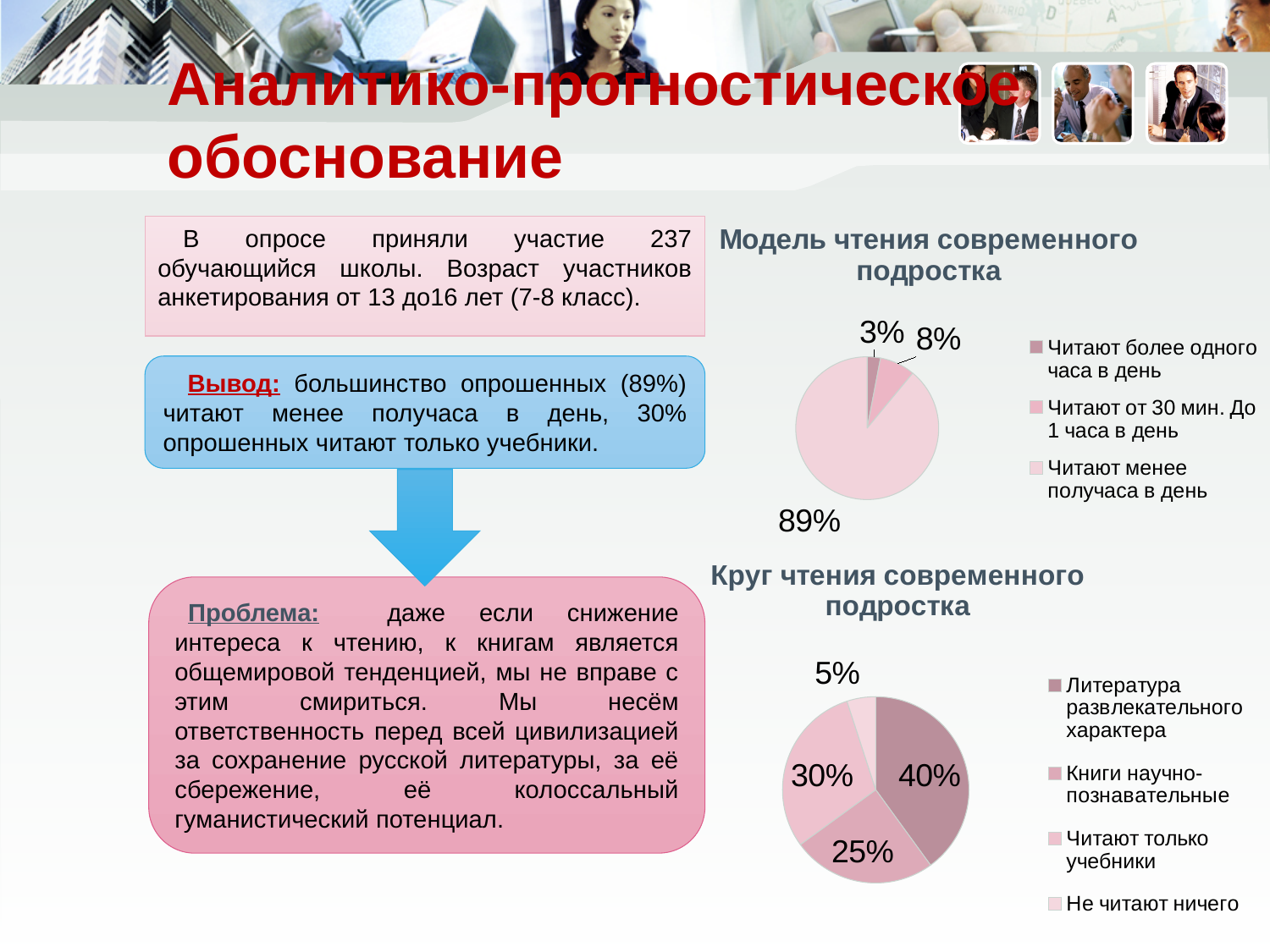
On the chart titled «Модель чтения современного подростка», what share of respondents read from 30 minutes to 1 hour a day? 8% On the chart titled «Круг чтения современного подростка», what share is «Литература развлекательного характера»? 40% On the chart titled «Круг чтения современного подростка», which category has the smallest slice? Не читают ничего On the chart titled «Модель чтения современного подростка», how many categories does the legend list? 3 What kind of chart is «Модель чтения современного подростка»? Pie chart On the chart titled «Круг чтения современного подростка», how many categories does the legend list? 4 On the chart titled «Круг чтения современного подростка», what share of respondents read only textbooks («Читают только учебники»)? 30% On the chart titled «Модель чтения современного подростка», what share of respondents read more than one hour a day («Читают более одного часа в день»)? 3% On the chart titled «Круг чтения современного подростка», what share is «Не читают ничего»? 5% On the chart titled «Модель чтения современного подростка», what share of respondents read less than half an hour a day («Читают менее получаса в день»)? 89% On the chart titled «Модель чтения современного подростка», which category has the largest slice? Читают менее получаса в день On the chart titled «Круг чтения современного подростка», what is the difference between the share for «Литература развлекательного характера» and the share for «Книги научно-познавательные»? 15%